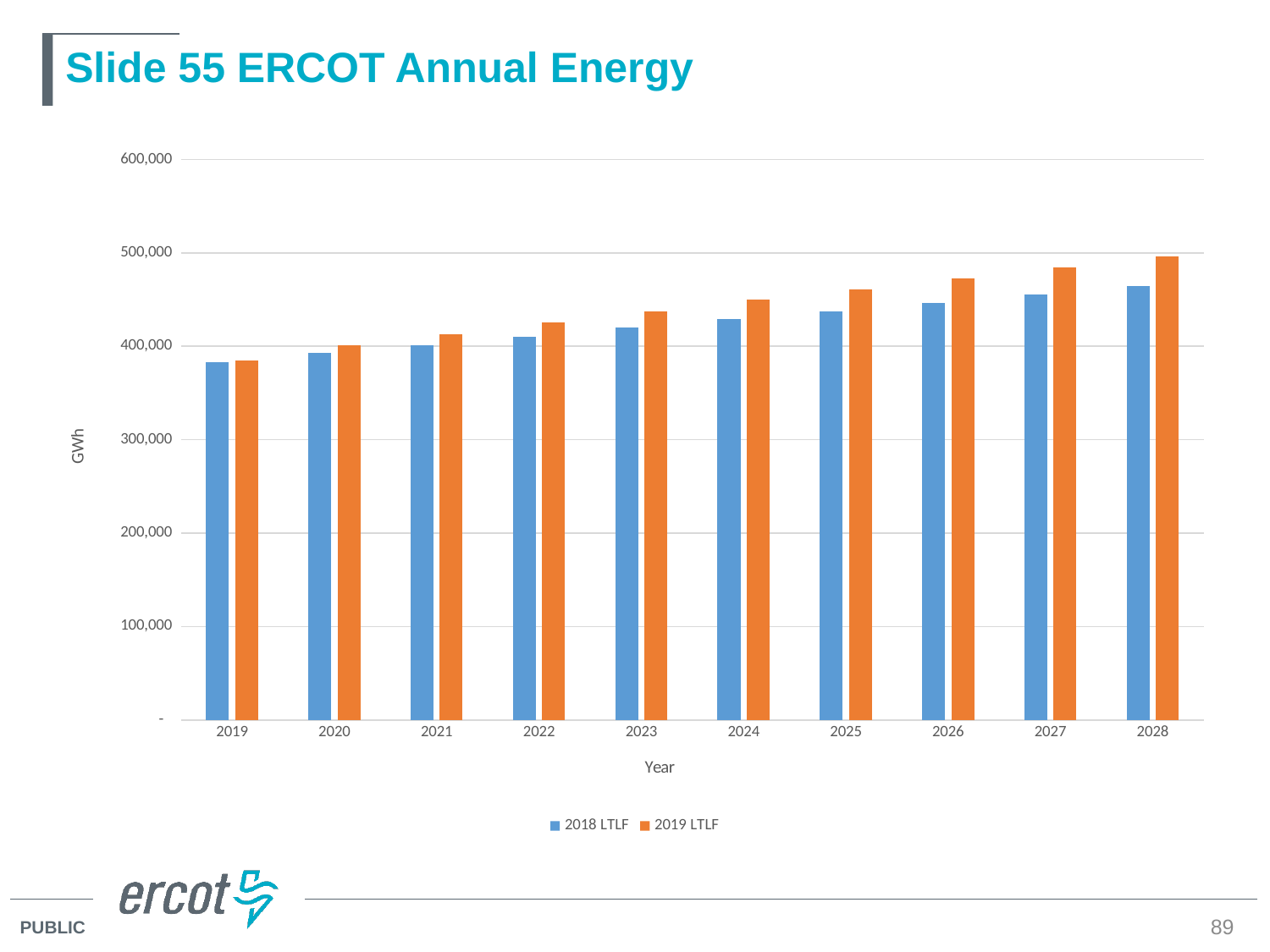
Do the 2019 LTLF values rise or fall from 2019 to 2028? rise What is the label on the y axis? GWh Is the 2018 LTLF value for 2028 greater or less than 500,000? less Is the 2019 LTLF value for 2028 greater or less than 400,000? greater In 2028, which series has the larger value, 2018 LTLF or 2019 LTLF? 2019 LTLF What kind of chart is shown on the slide? bar chart Which year has the highest 2019 LTLF value? 2028 How many series does the legend list? 2 Which year has the lowest 2018 LTLF value? 2019 Is the 2019 LTLF value for 2024 greater or less than 400,000? greater How many years are shown on the x axis? 10